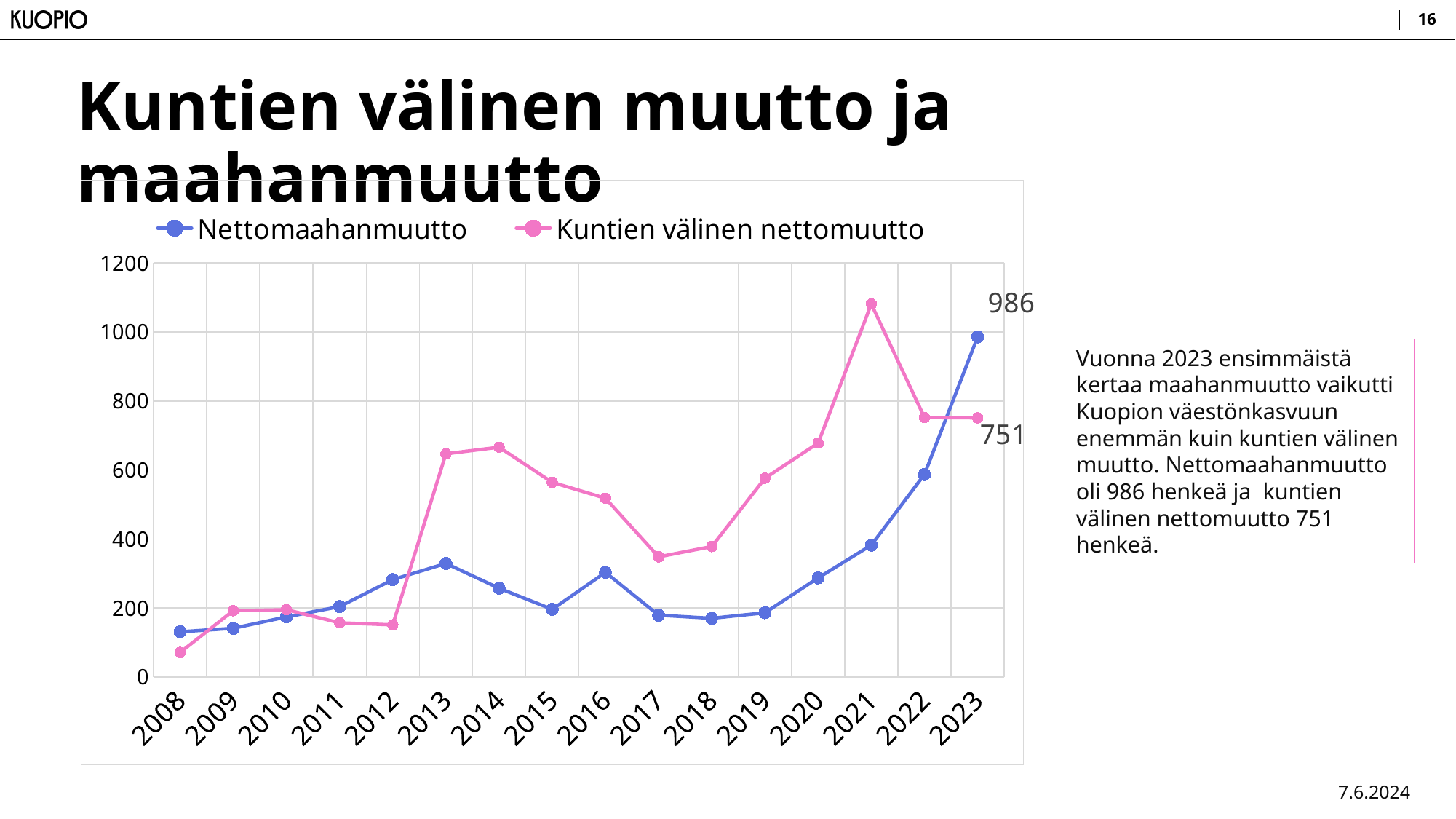
What kind of chart is shown on the slide? Line chart What is the value of Kuntien välinen nettomuutto in 2023? 751 What is the difference between Nettomaahanmuutto and Kuntien välinen nettomuutto in 2023? 235 Is the value of Nettomaahanmuutto in 2018 greater or less than 200? less How many years are shown on the x axis? 16 In which year does Nettomaahanmuutto reach its highest value? 2023 Is the value of Kuntien välinen nettomuutto in 2021 greater or less than 1000? greater Which series has the higher value in 2023, Nettomaahanmuutto or Kuntien välinen nettomuutto? Nettomaahanmuutto How many series does the legend list? 2 In which year does Kuntien välinen nettomuutto reach its highest value? 2021 What is the value of Nettomaahanmuutto in 2023? 986 In which year is Kuntien välinen nettomuutto at its lowest? 2008